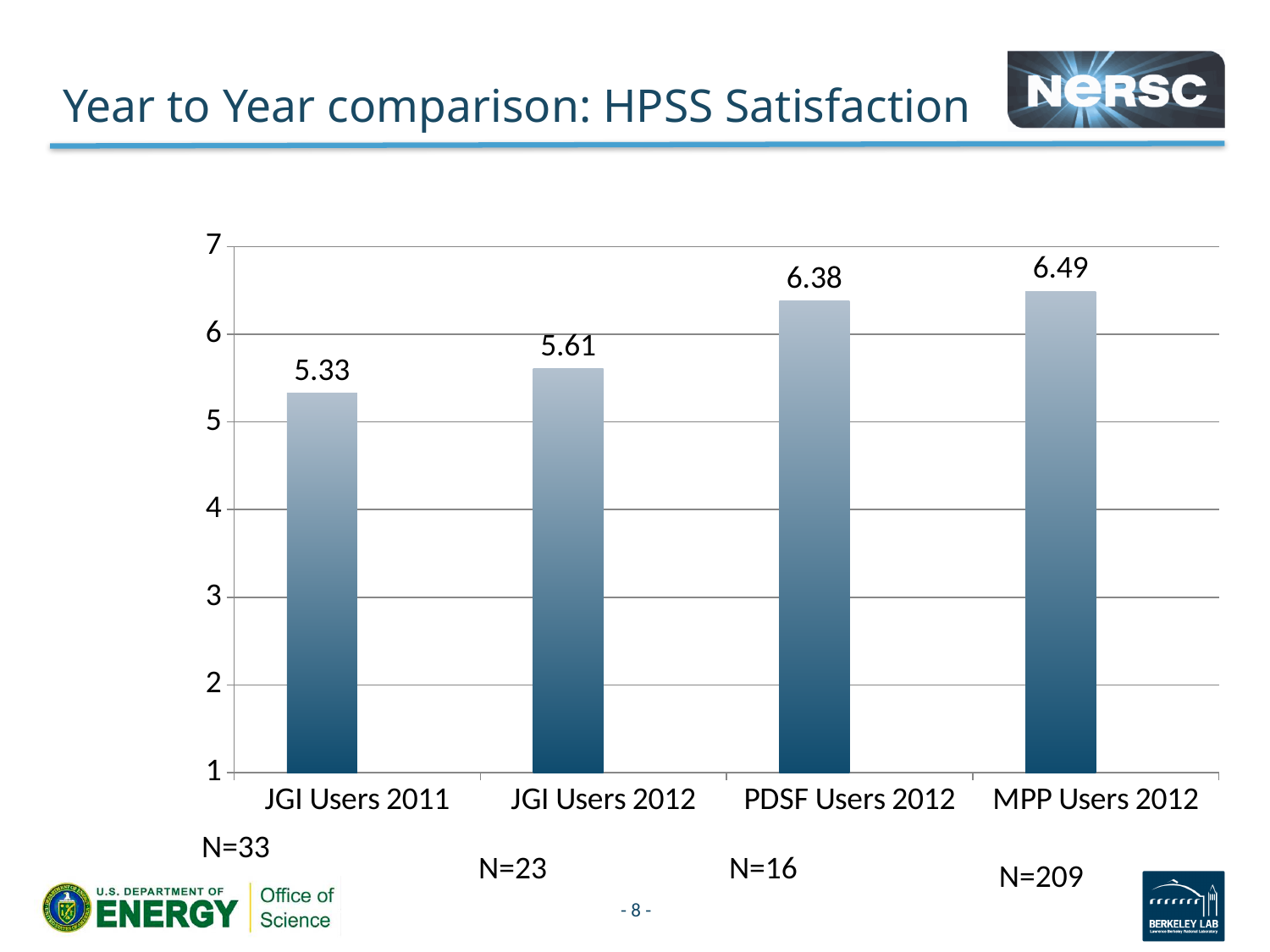
What is the N value shown for MPP Users 2012? N=209 Which category has the highest HPSS satisfaction value? MPP Users 2012 What is the HPSS satisfaction value for MPP Users 2012? 6.49 Which is larger, the value for PDSF Users 2012 or the value for JGI Users 2012? PDSF Users 2012 What is the HPSS satisfaction value for PDSF Users 2012? 6.38 Do the values rise or fall from left to right across the categories? rise Is the value for JGI Users 2012 greater or less than 6? less Which category has the lowest HPSS satisfaction value? JGI Users 2011 What is the difference between the values for JGI Users 2012 and JGI Users 2011? 0.28 What is the HPSS satisfaction value for JGI Users 2011? 5.33 What kind of chart is shown on the slide? bar chart How many categories are shown on the chart? 4